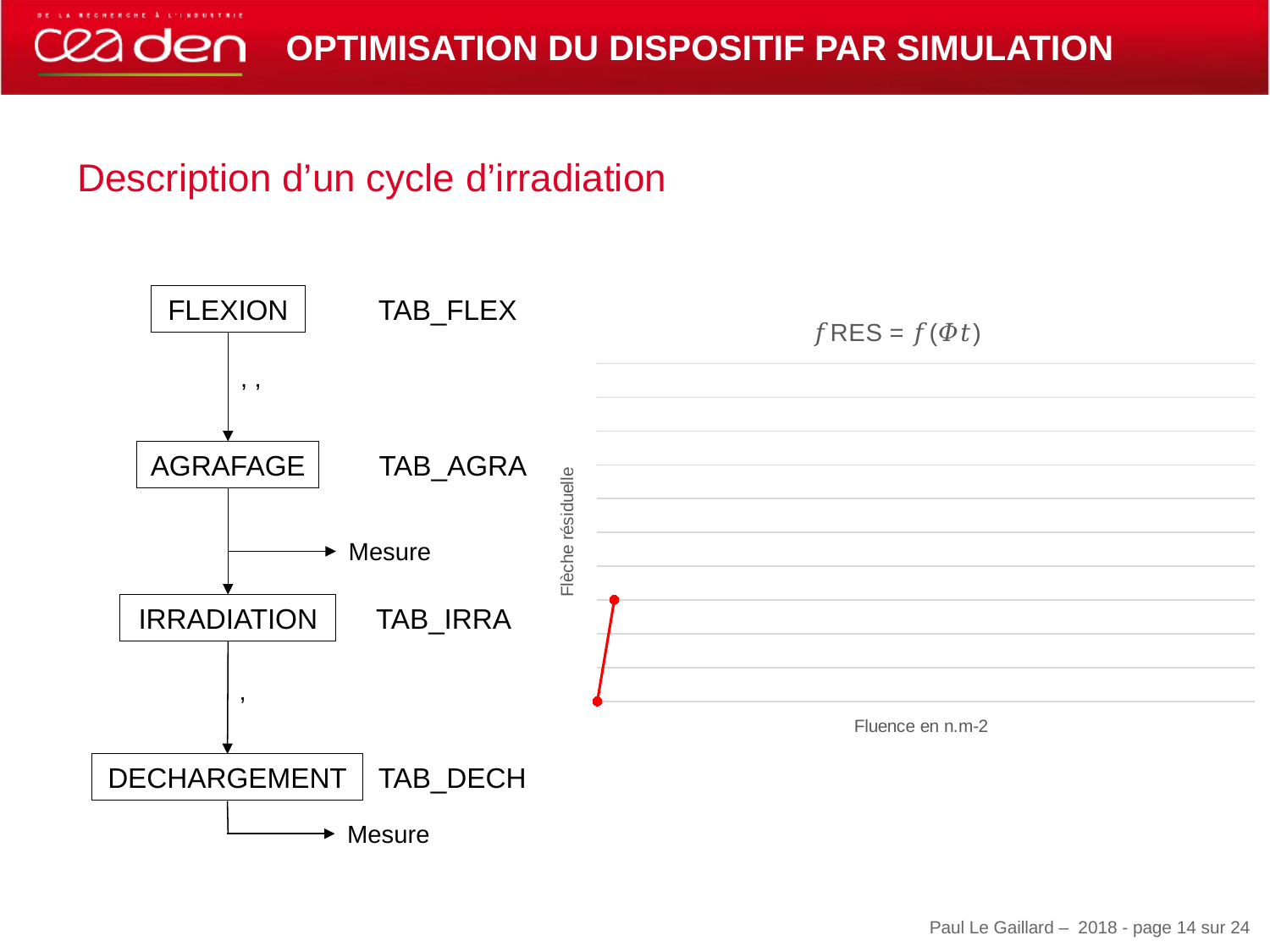
Does the plotted line rise or fall from left to right along the x axis? rise What is the label of the vertical axis of the chart? Flèche résiduelle How many data points are plotted on the chart? 2 What is the title of the chart? fRES = f(Φt) What kind of chart is shown on the slide? line chart